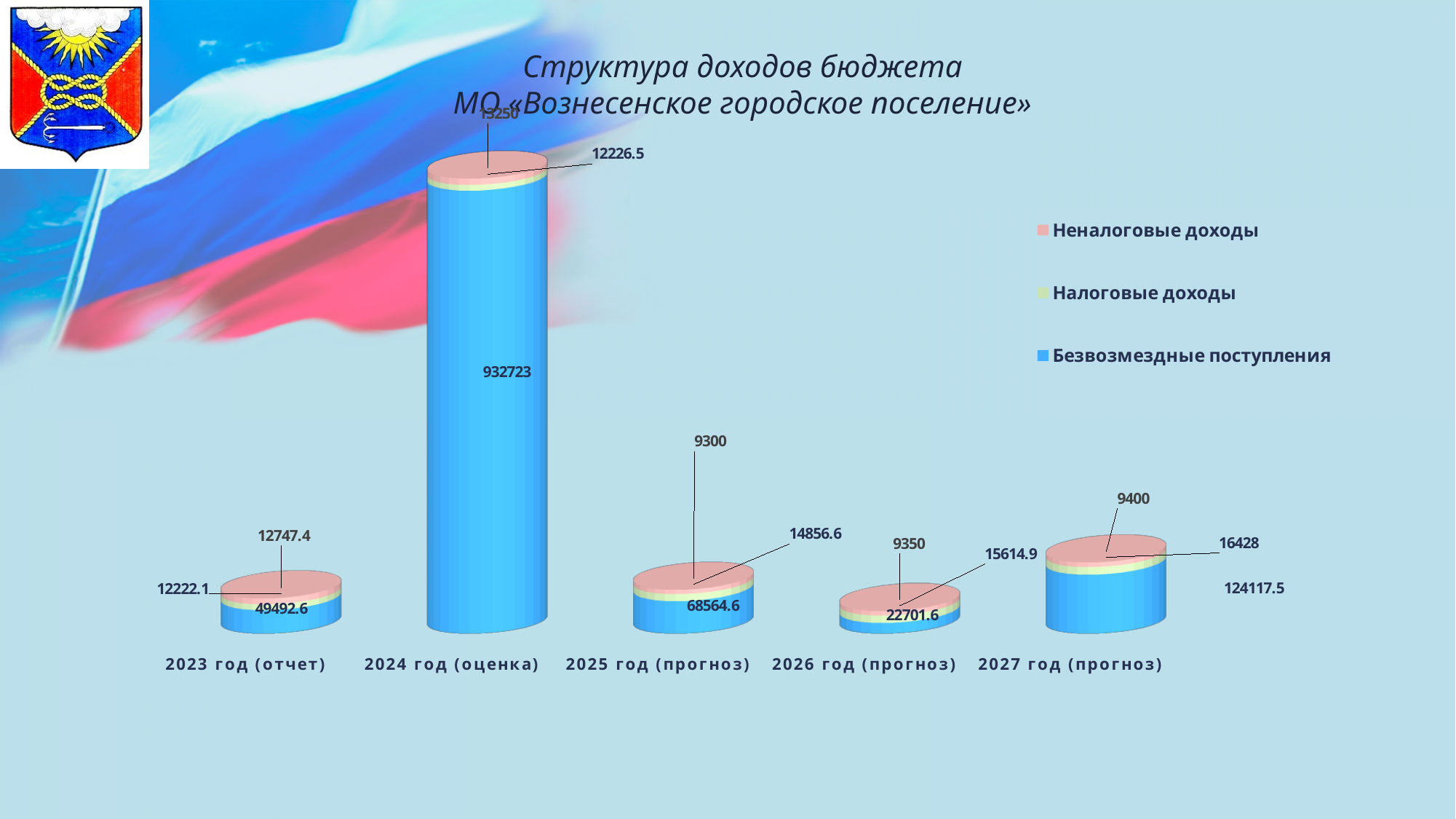
What is the value of Безвозмездные поступления for 2023 год (отчет)? 49492.6 Which year has the lowest value of Безвозмездные поступления? 2026 год (прогноз) Do the values of Налоговые доходы rise or fall from 2023 to 2027? Rise What kind of chart is shown on the slide? Stacked bar chart What is the difference between Налоговые доходы in 2027 год (прогноз) and 2026 год (прогноз)? 813.1 What is the value of Неналоговые доходы for 2027 год (прогноз)? 9400 How many series does the legend list? 3 Which is larger: Безвозмездные поступления in 2025 год (прогноз) or in 2027 год (прогноз)? 2027 год (прогноз) What is the value of Налоговые доходы for 2025 год (прогноз)? 14856.6 How many years (categories) are shown on the x axis? 5 Which year has the highest value of Безвозмездные поступления? 2024 год (оценка) What is the value of Безвозмездные поступления for 2024 год (оценка)? 932723